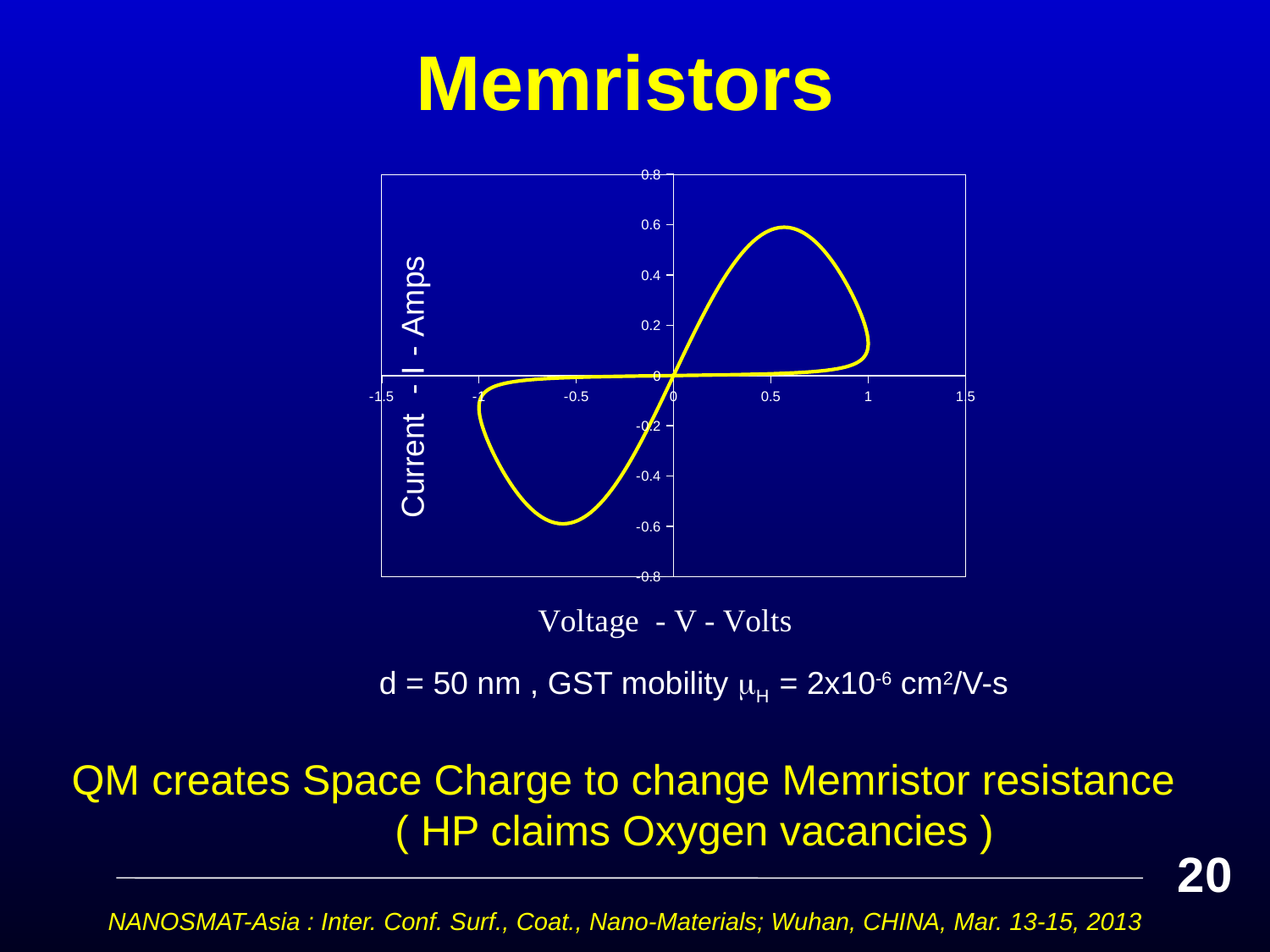
What is the highest value shown on the vertical axis of the chart? 0.8 Is the peak positive current reached by the curve greater or less than 0.4 Amps? greater Does the current rise or fall as the voltage increases from -1 to -0.5 Volts along the lower branch of the curve? fall Is the most negative current reached by the curve greater or less than -0.4 Amps? less Is the maximum voltage reached by the curve greater or less than 0.5 Volts? greater What is the label of the vertical axis of the chart? Current - I - Amps How many curves are plotted on the chart? 1 Does the current rise or fall as the voltage increases from 0 to 0.5 Volts along the upper branch of the curve? rise What is the label of the horizontal axis of the chart? Voltage - V - Volts What kind of chart is shown on the slide? line chart